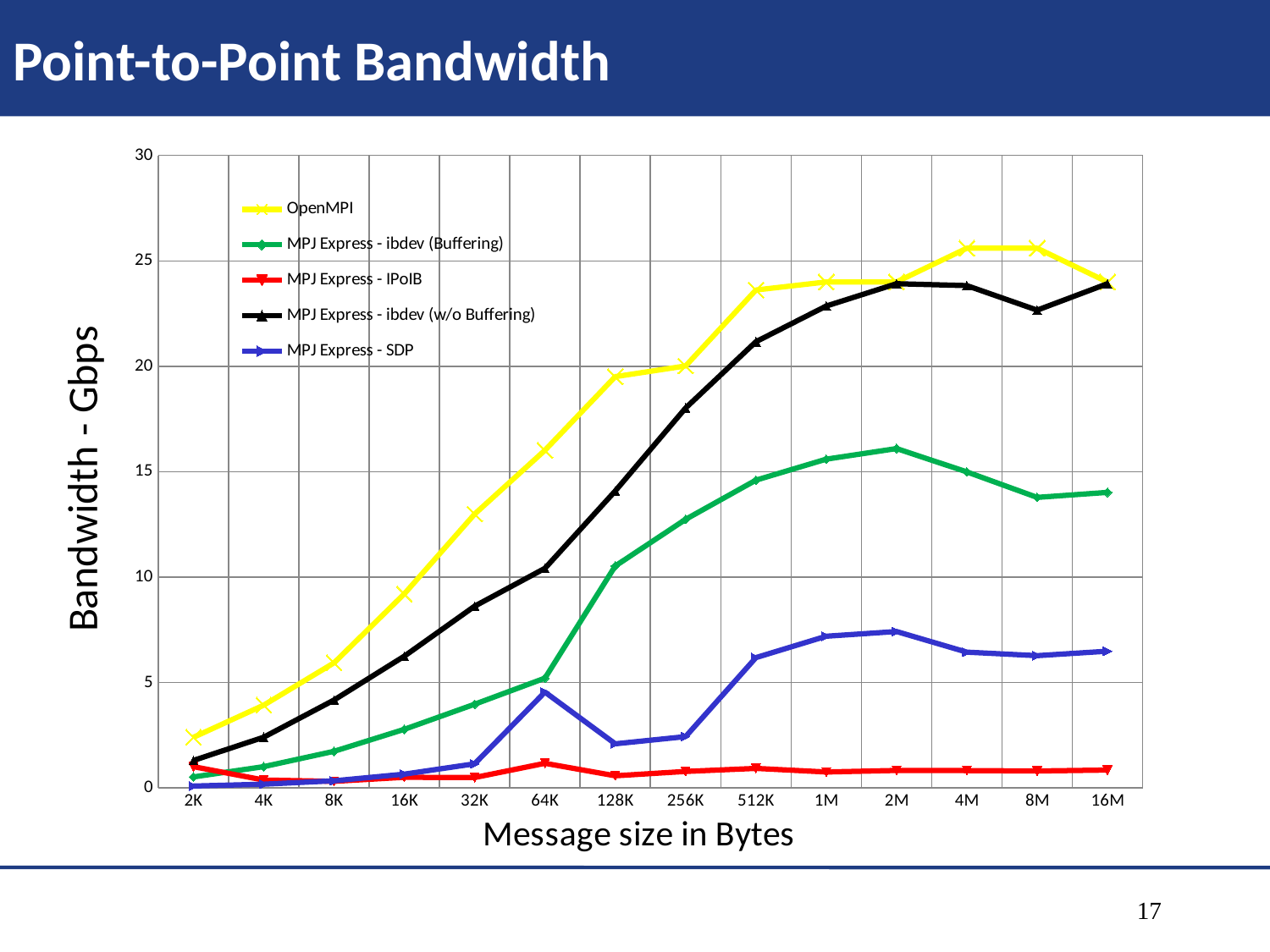
Is the bandwidth for MPJ Express - ibdev (Buffering) at 2M greater or less than 15? greater How many series does the legend list? 5 At a message size of 128K, which is larger: MPJ Express - ibdev (w/o Buffering) or MPJ Express - ibdev (Buffering)? MPJ Express - ibdev (w/o Buffering) How many message sizes are shown along the x axis? 14 What is the title of the x axis? Message size in Bytes What kind of chart is shown on the slide? line chart Which series has the highest bandwidth at a message size of 4M? OpenMPI Is the bandwidth for MPJ Express - SDP at 2M greater or less than 5? greater Is the bandwidth for OpenMPI at 512K greater or less than 20? greater At a message size of 16M, which is larger: MPJ Express - SDP or MPJ Express - IPoIB? MPJ Express - SDP Which series has the lowest bandwidth at a message size of 16M? MPJ Express - IPoIB Does the OpenMPI bandwidth rise or fall from 2K to 512K? rise